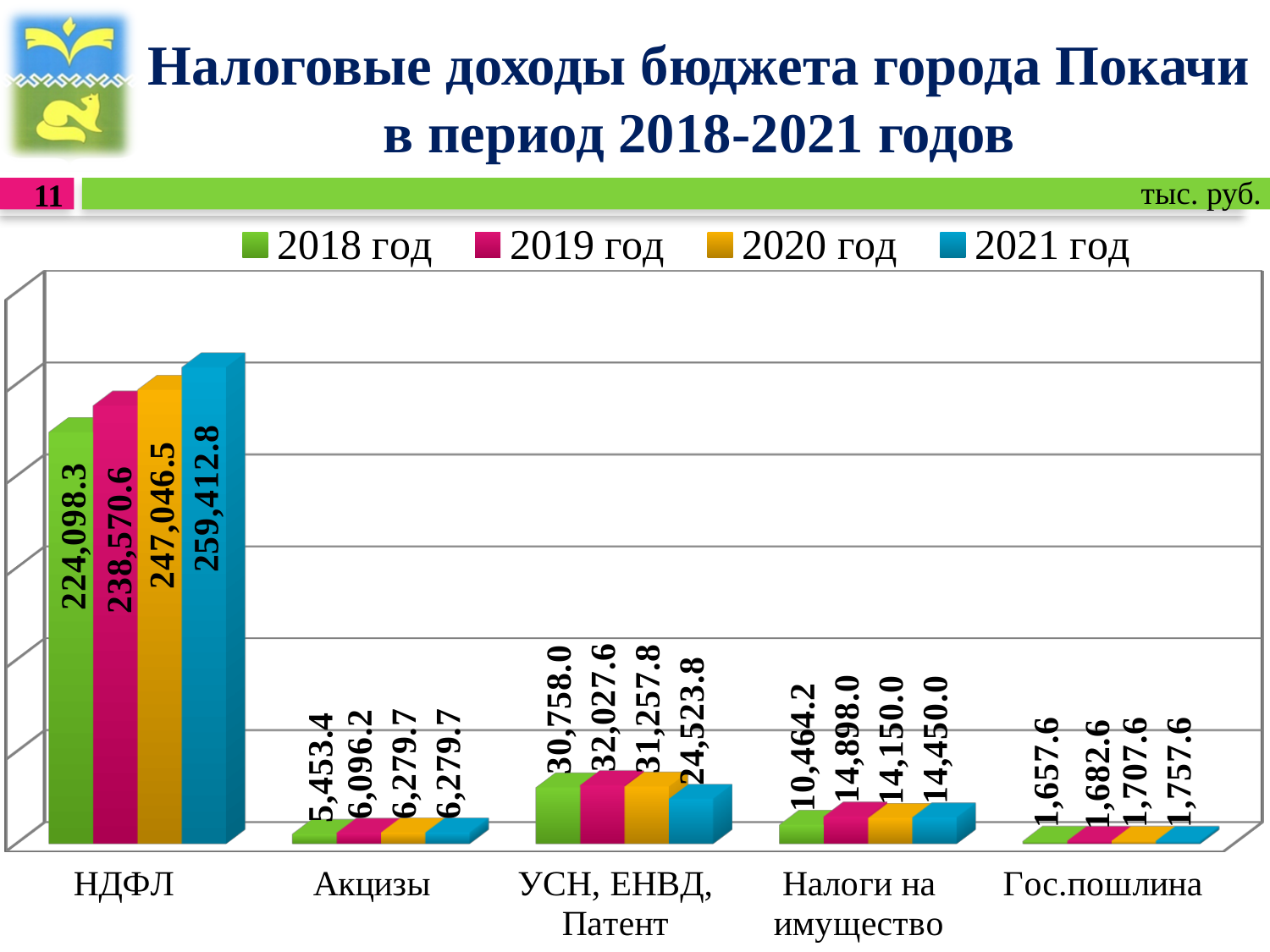
What kind of chart is shown on the slide? Bar chart Which category has the lowest value in 2019 год? Гос.пошлина How many categories are shown on the x axis? 5 What is the difference between the 2019 год and 2018 год values for Налоги на имущество? 4,433.8 Which category has the highest value in 2021 год? НДФЛ Which is larger for УСН, ЕНВД, Патент: the 2019 год value or the 2021 год value? 2019 год What is the value for Гос.пошлина in 2020 год? 1,707.6 How many series does the legend list? 4 What is the difference between the 2021 год and 2018 год values for НДФЛ? 35,314.5 What is the value for НДФЛ in 2018 год? 224,098.3 What is the value for УСН, ЕНВД, Патент in 2021 год? 24,523.8 Do the values for Гос.пошлина rise or fall from 2018 год to 2021 год? Rise